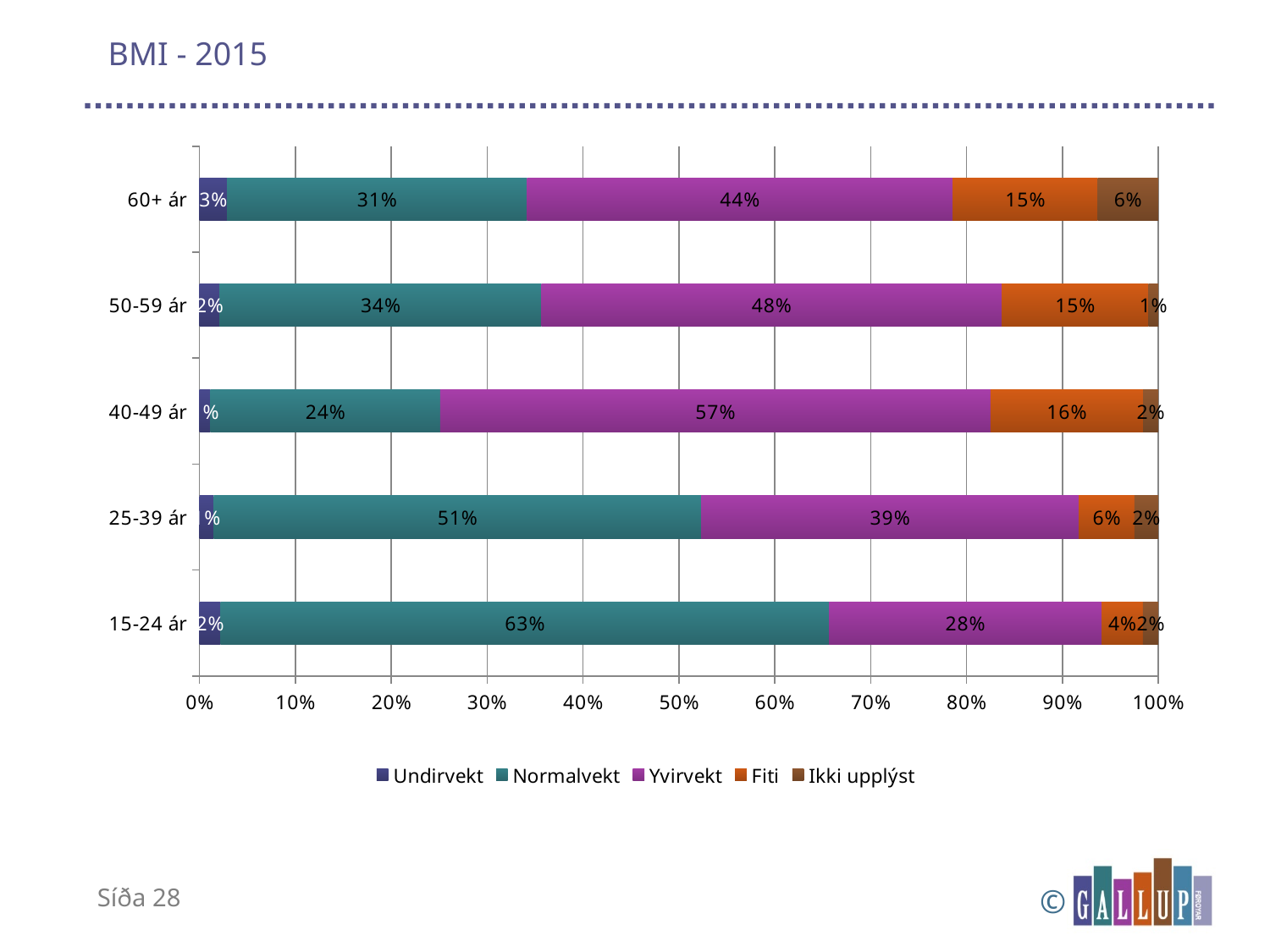
What is the Ikki upplýst value for the 50-59 ár group? 1% How many series does the legend list? 5 What is the Fiti value for the 60+ ár group? 15% What kind of chart is shown on the slide? Stacked bar chart What is the title of the chart? BMI - 2015 Which age group has the highest Normalvekt value? 15-24 ár How many age groups are shown on the chart? 5 Which is larger, the Fiti value for 40-49 ár or for 25-39 ár? 40-49 ár What is the difference between the Yvirvekt values for 40-49 ár and 25-39 ár? 18% What is the Normalvekt value for the 15-24 ár group? 63% Which age group has the lowest Yvirvekt value? 15-24 ár What is the Yvirvekt value for the 40-49 ár group? 57%